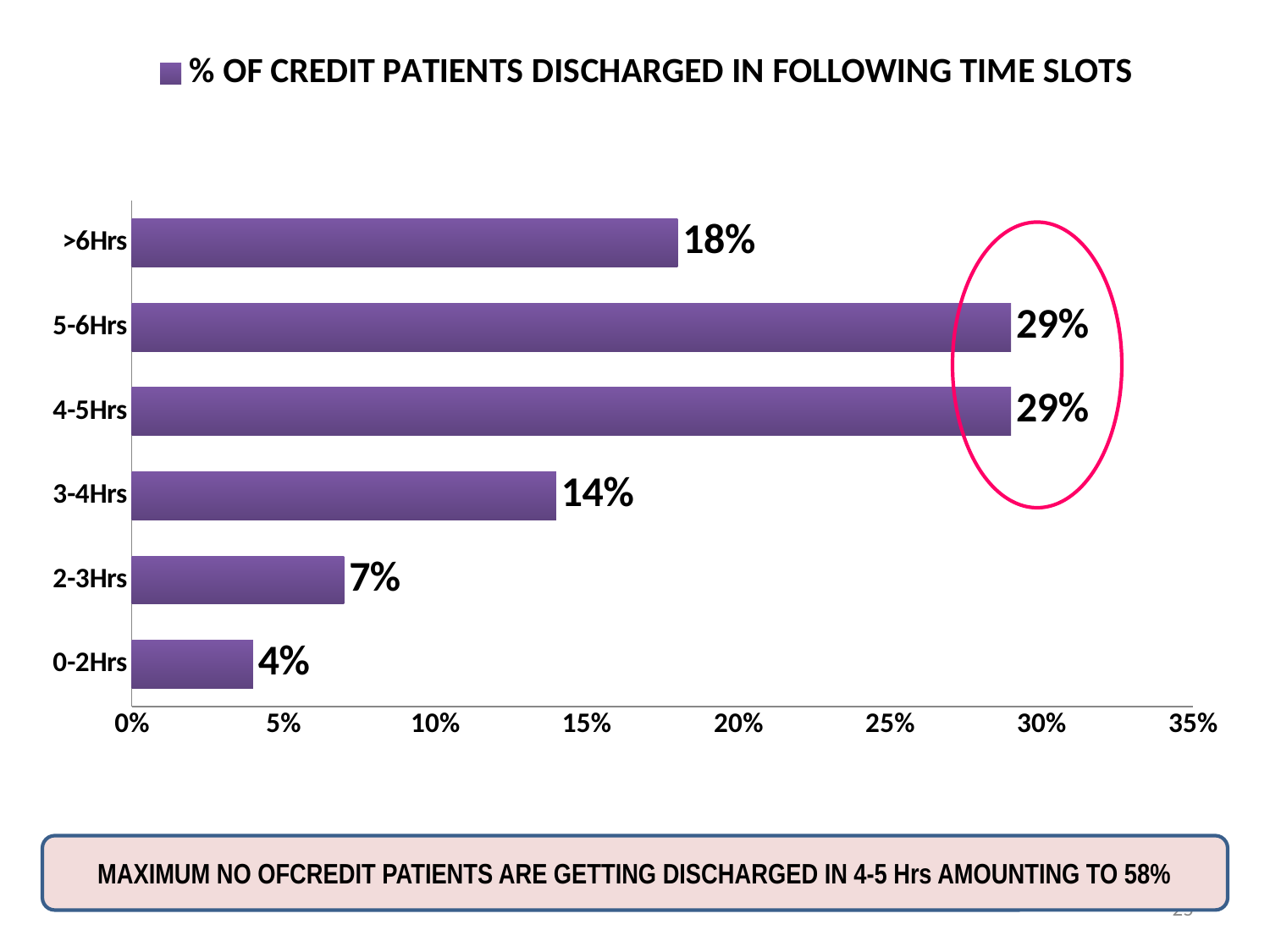
What is the difference between the percentage for 3-4Hrs and the percentage for 2-3Hrs? 7% Is the value for 4-5Hrs greater or less than 25%? greater What is the combined percentage for the 4-5Hrs and 5-6Hrs time slots? 58% What percentage of credit patients were discharged in the 0-2Hrs time slot? 4% What is the difference between the percentage for 5-6Hrs and the percentage for >6Hrs? 11% What percentage of credit patients were discharged in the 3-4Hrs time slot? 14% Which is larger, the percentage for >6Hrs or the percentage for 3-4Hrs? >6Hrs What type of chart is shown on the slide? Bar chart What percentage of credit patients were discharged in the >6Hrs time slot? 18% Which time slot has the lowest percentage of credit patients discharged? 0-2Hrs What percentage of credit patients were discharged in the 2-3Hrs time slot? 7% How many time slot categories are shown in the chart? 6